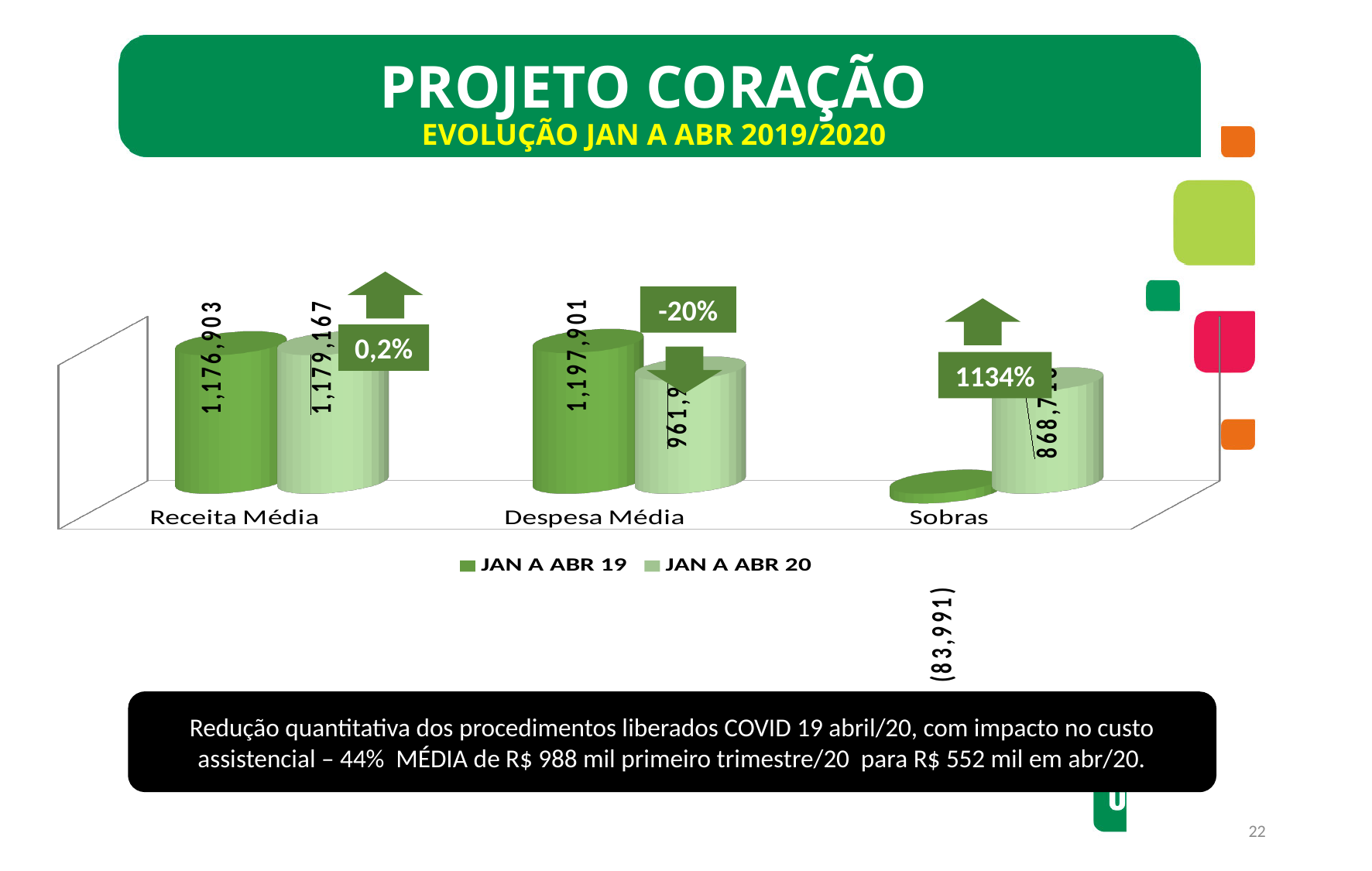
For Receita Média, which series has the larger value, JAN A ABR 19 or JAN A ABR 20? JAN A ABR 20 What is the value for Receita Média in the JAN A ABR 19 series? 1,176,903 What is the difference between the JAN A ABR 20 and JAN A ABR 19 values for Receita Média? 2,264 What is the value for Despesa Média in the JAN A ABR 19 series? 1,197,901 What is the value for Sobras in the JAN A ABR 19 series? (83,991) What kind of chart is shown on the slide? bar chart What percentage change label is shown above the Despesa Média bars? -20% How many categories are shown on the x axis? 3 What is the value for Receita Média in the JAN A ABR 20 series? 1,179,167 How many series does the legend list? 2 For Despesa Média, which series has the larger value, JAN A ABR 19 or JAN A ABR 20? JAN A ABR 19 Which category has the lowest value in the JAN A ABR 19 series? Sobras